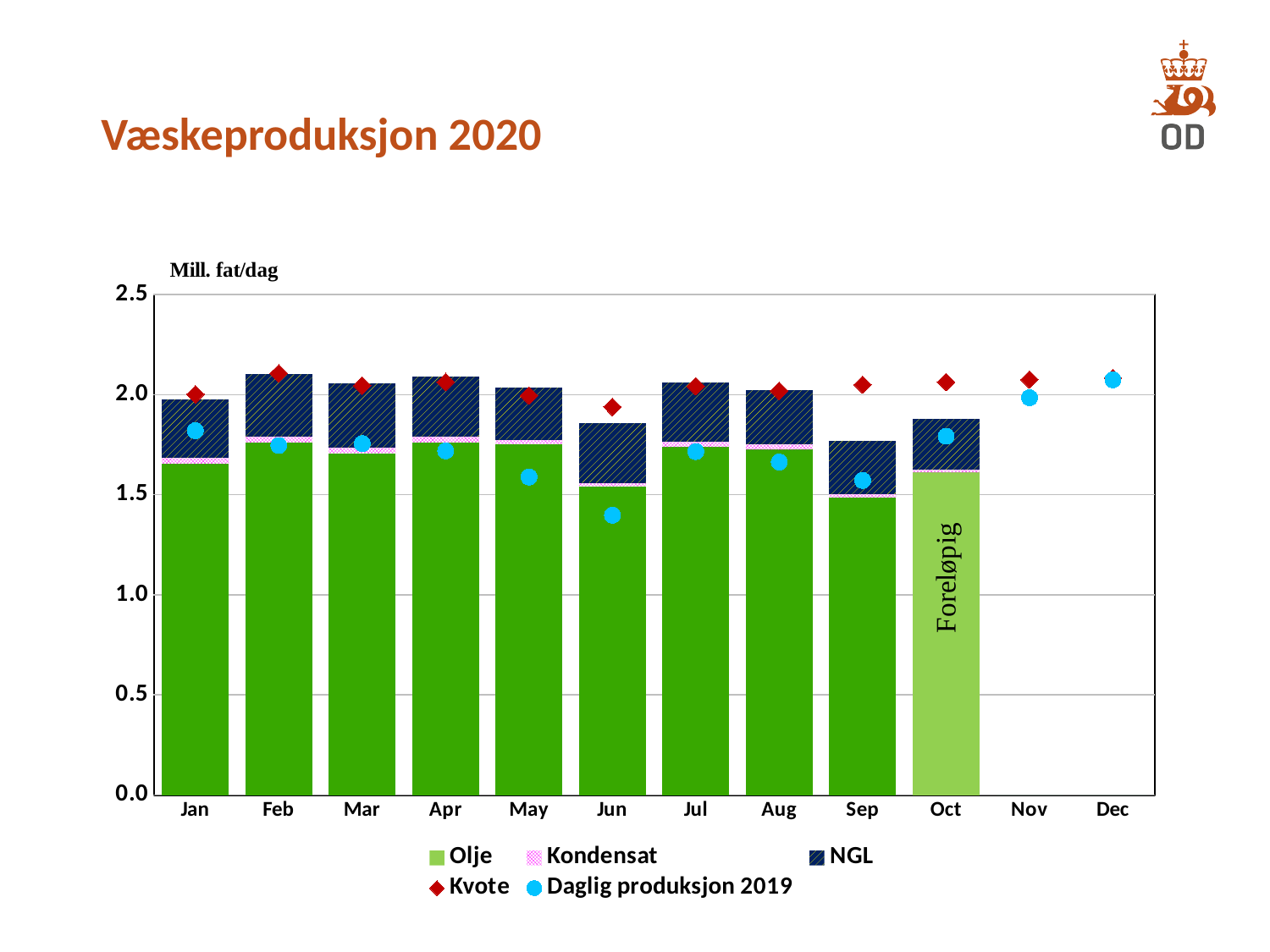
Which month has the highest total stacked bar? Feb Is the Daglig produksjon 2019 value for Jun greater or less than 1.5? less What is the title of the slide? Væskeproduksjon 2020 Which month's bar is labelled "Foreløpig"? Oct Is the total stacked bar for Jun greater or less than 2.0? less Which month has the lowest Daglig produksjon 2019 value? Jun Is the Olje value for Jan greater or less than 1.5? greater How many series does the legend list? 5 Which is larger, the total stacked bar for Feb or for Jun? Feb How many months have a stacked bar plotted? 10 What kind of chart is shown on the slide? Stacked bar chart with line markers